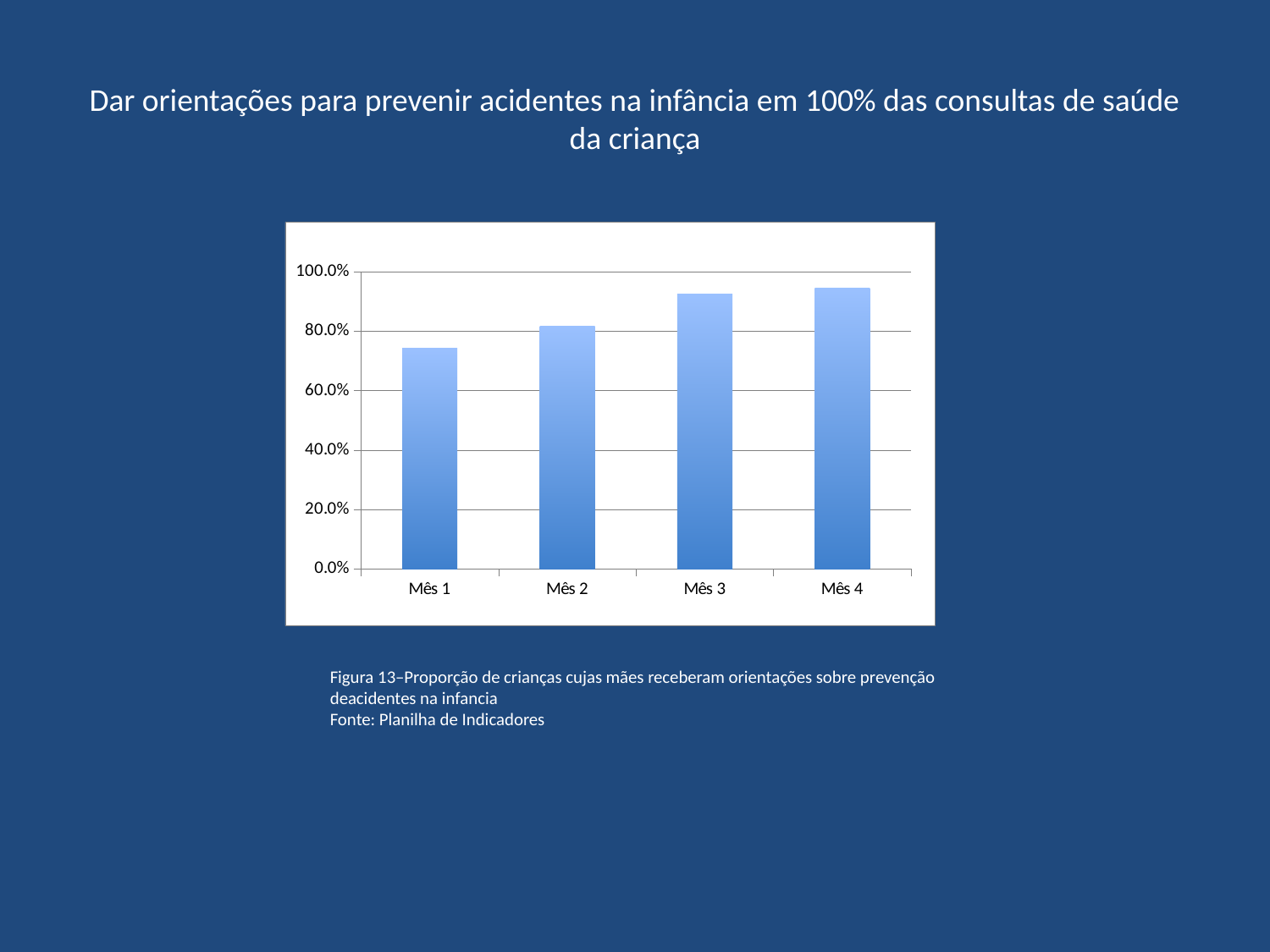
How many categories (months) are plotted on the x axis? 4 What is the maximum value shown on the vertical axis? 100.0% Is the value for Mês 1 greater or less than 60.0%? greater Is the value for Mês 3 greater or less than 80.0%? greater Which is larger, the value for Mês 1 or the value for Mês 2? Mês 2 Is the value for Mês 1 greater or less than 80.0%? less What kind of chart is shown on the slide? bar chart Do the values rise or fall from Mês 1 to Mês 4? rise Which month has the lowest value? Mês 1 Which is larger, the value for Mês 2 or the value for Mês 3? Mês 3